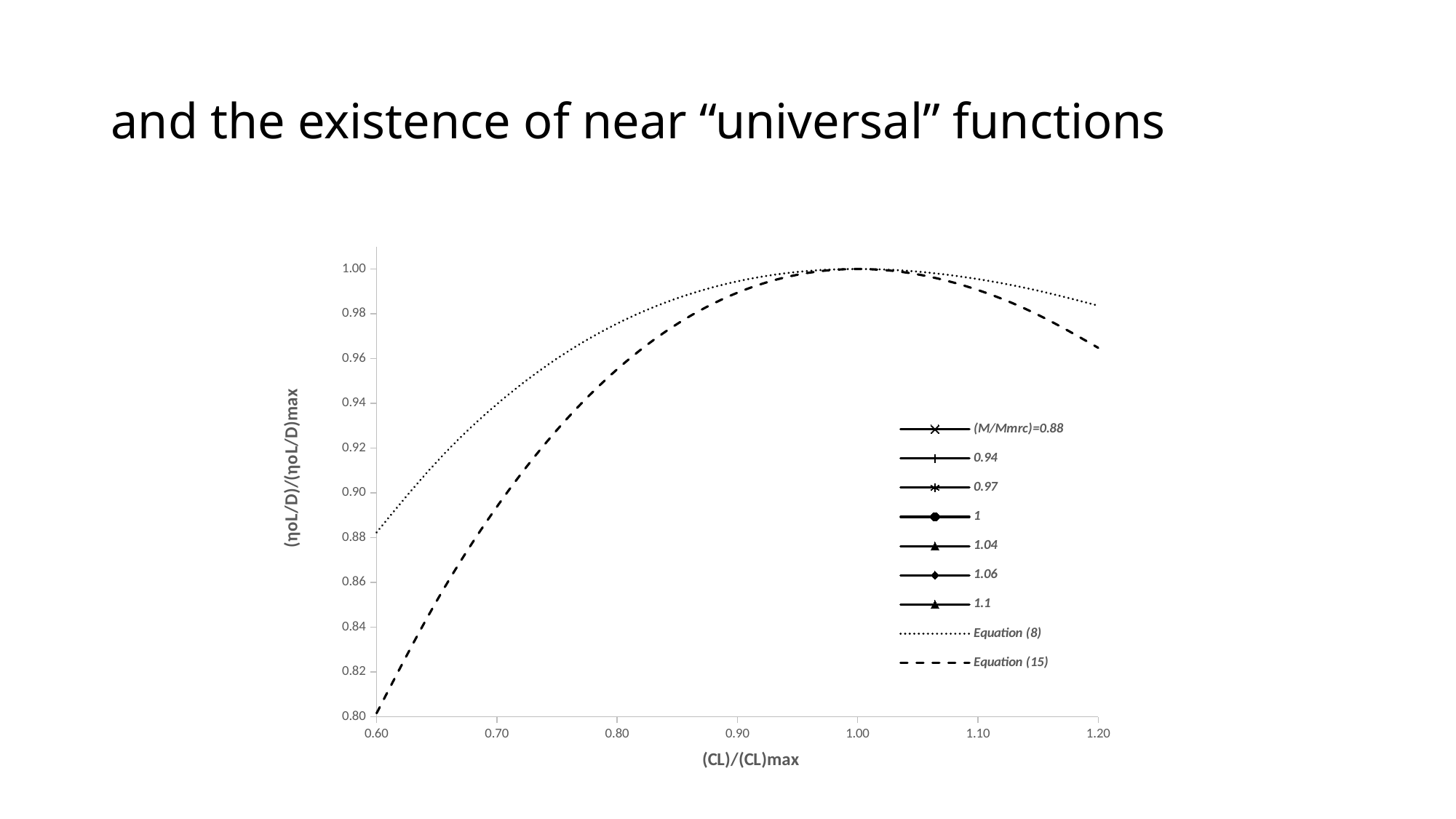
Is the value of the Equation (15) curve at (CL)/(CL)max = 0.65 greater or less than 0.86? less Does the Equation (15) curve rise or fall as (CL)/(CL)max increases from 0.60 to 1.00? rise Is the value of the Equation (8) curve at (CL)/(CL)max = 1.20 greater or less than 0.98? greater At (CL)/(CL)max = 1.00, what value do the Equation (8) and Equation (15) curves reach? 1.00 Which legend entry is drawn with a dashed line? Equation (15) At (CL)/(CL)max = 0.60, which curve is higher, Equation (8) or Equation (15)? Equation (8) What kind of chart is shown on the slide? line chart At (CL)/(CL)max = 1.20, which curve is higher, Equation (8) or Equation (15)? Equation (8) How many series does the legend list? 9 Is the value of the Equation (15) curve at (CL)/(CL)max = 1.20 greater or less than 0.96? greater What is the title of the x axis? (CL)/(CL)max